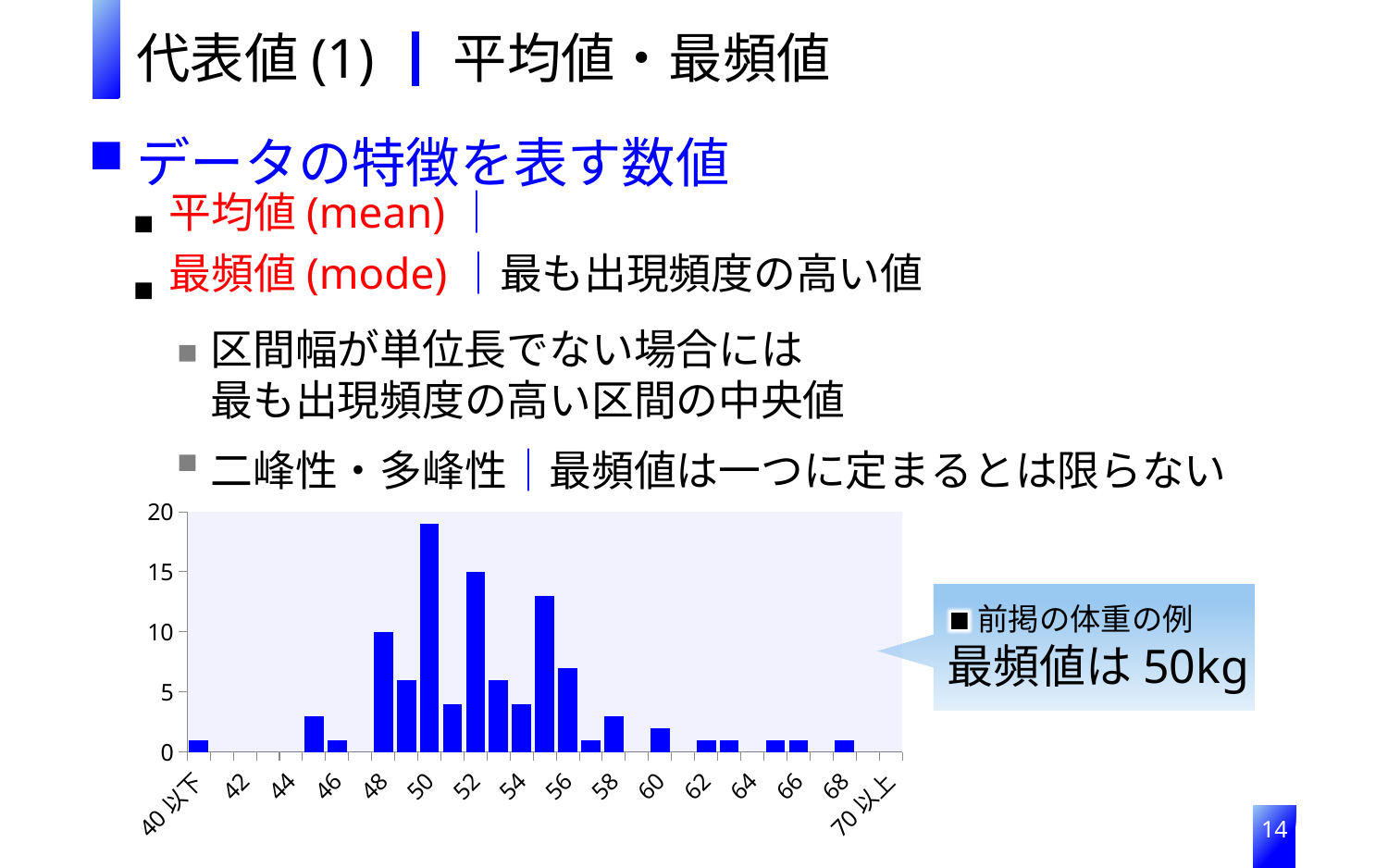
Is the value for 40以下 greater or less than 5? less What kind of chart is shown on the slide? bar chart Is the value for 58 greater or less than 5? less Which is larger, the value for 50 or the value for 52? 50 Is the value for 56 greater or less than 5? greater According to the callout next to the chart, what is the mode (最頻値) of the weight data? 50kg What is the highest tick value shown on the y-axis of the chart? 20 Which is larger, the value for 48 or the value for 56? 48 Which x-axis category has the tallest bar in the chart? 50